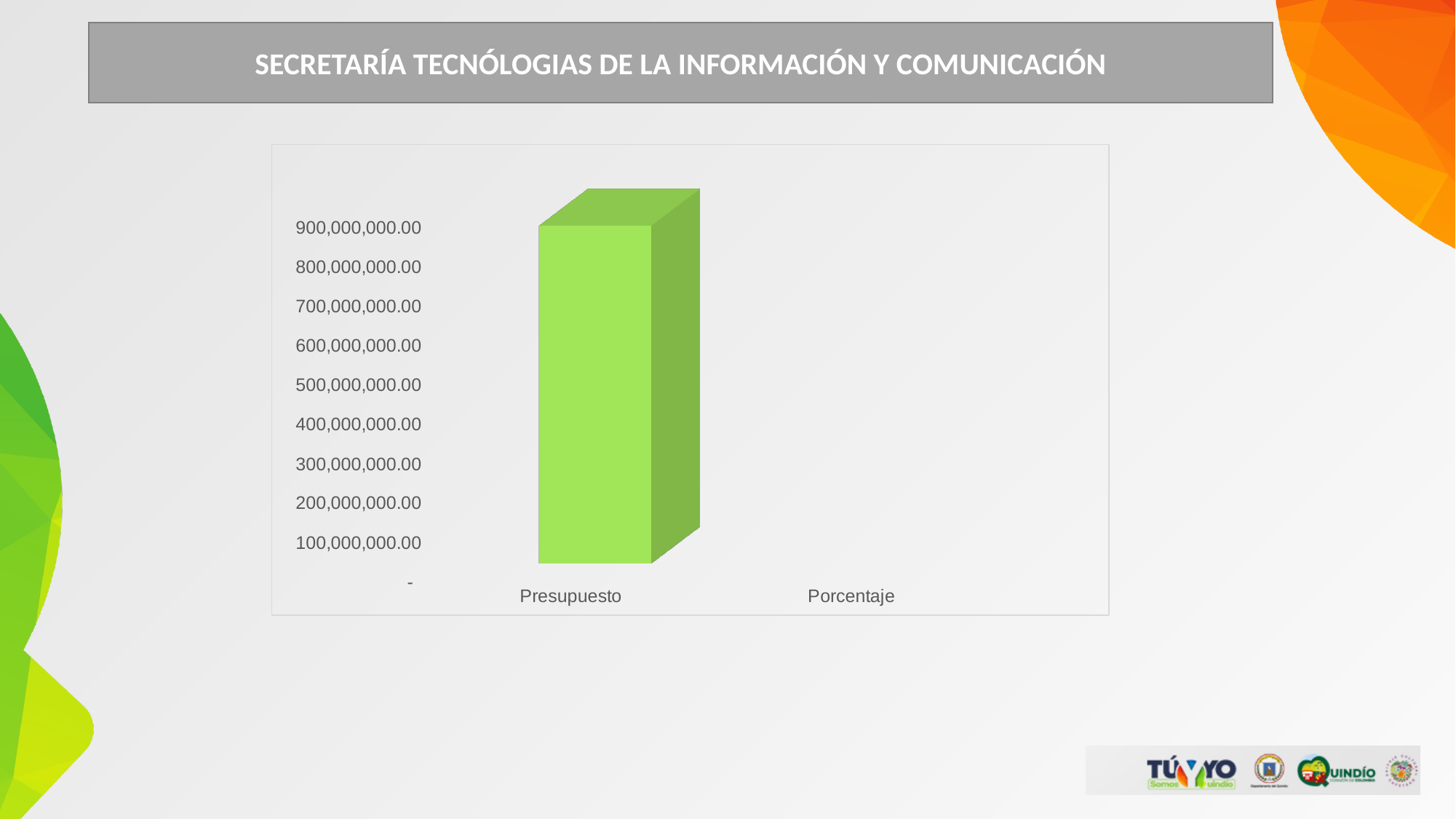
Which category has the highest value in the chart? Presupuesto How many categories are shown on the x axis of the chart? 2 Which category has the lowest value in the chart? Porcentaje Is the value for Presupuesto greater or less than 800,000,000.00? greater Is the value for Porcentaje greater or less than 100,000,000.00? less What kind of chart is shown on the slide? bar chart Which is larger, the value for Presupuesto or the value for Porcentaje? Presupuesto What is the highest tick label shown on the vertical axis of the chart? 900,000,000.00 What colour is the bar for Presupuesto? green Is the value for Presupuesto greater or less than 500,000,000.00? greater